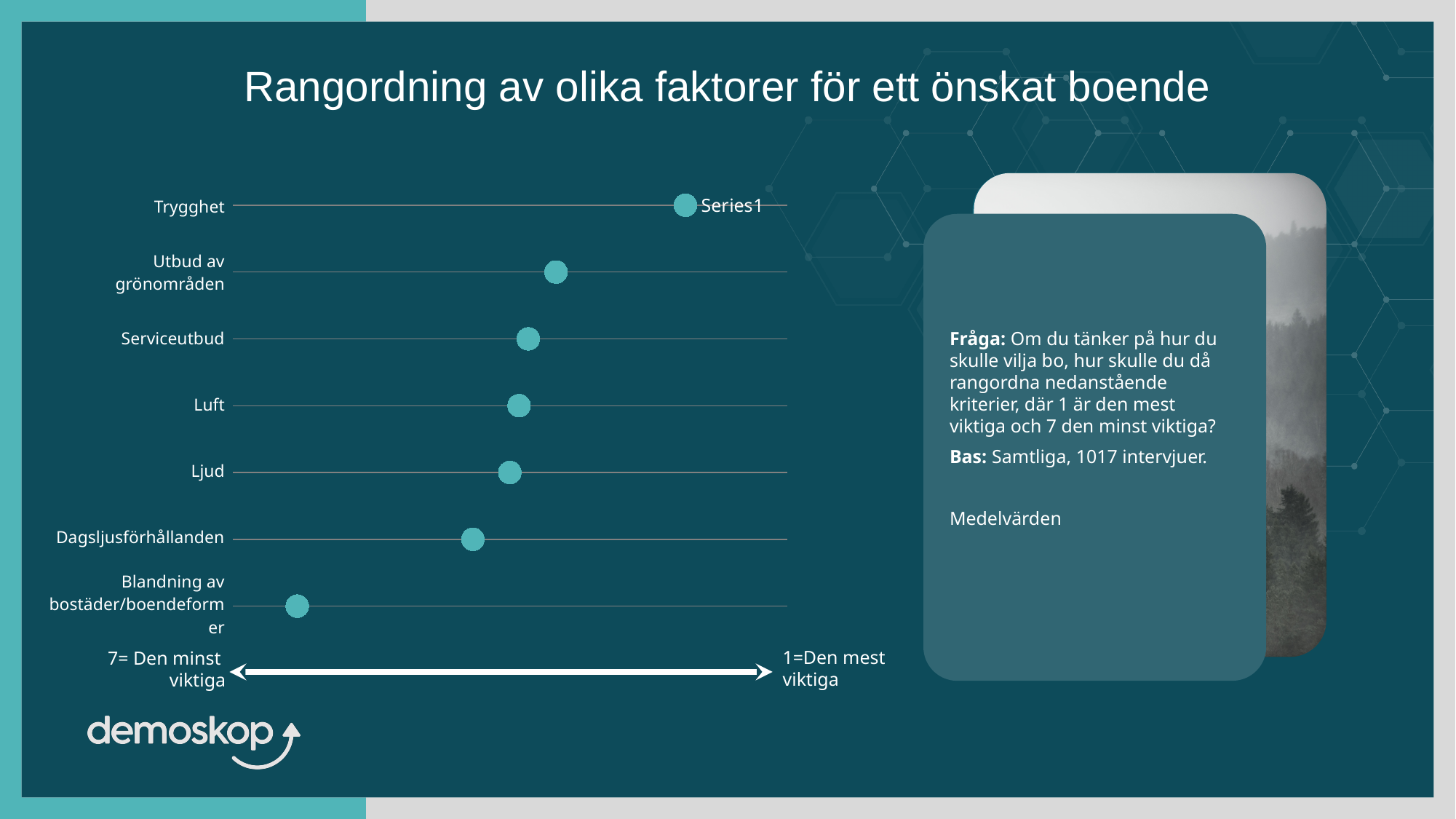
Which category's marker is positioned closest to the '7= Den minst viktiga' end of the axis? Blandning av bostäder/boendeformer Which category is ranked as more important (marker further toward '1=Den mest viktiga'): Utbud av grönområden or Dagsljusförhållanden? Utbud av grönområden What is the title of the chart on the slide? Rangordning av olika faktorer för ett önskat boende Which category's marker is positioned closest to the '1=Den mest viktiga' end of the axis? Trygghet How many categories (factors) are plotted on the chart? 7 Which category is ranked as more important (marker further toward '1=Den mest viktiga'): Trygghet or Blandning av bostäder/boendeformer? Trygghet Which category is listed at the top of the chart? Trygghet What series name is shown next to the top marker on the chart? Series1 Which category is ranked as less important (marker further toward '7= Den minst viktiga'): Dagsljusförhållanden or Serviceutbud? Dagsljusförhållanden Which category is listed at the bottom of the chart? Blandning av bostäder/boendeformer What kind of chart is shown on the slide? Dot plot